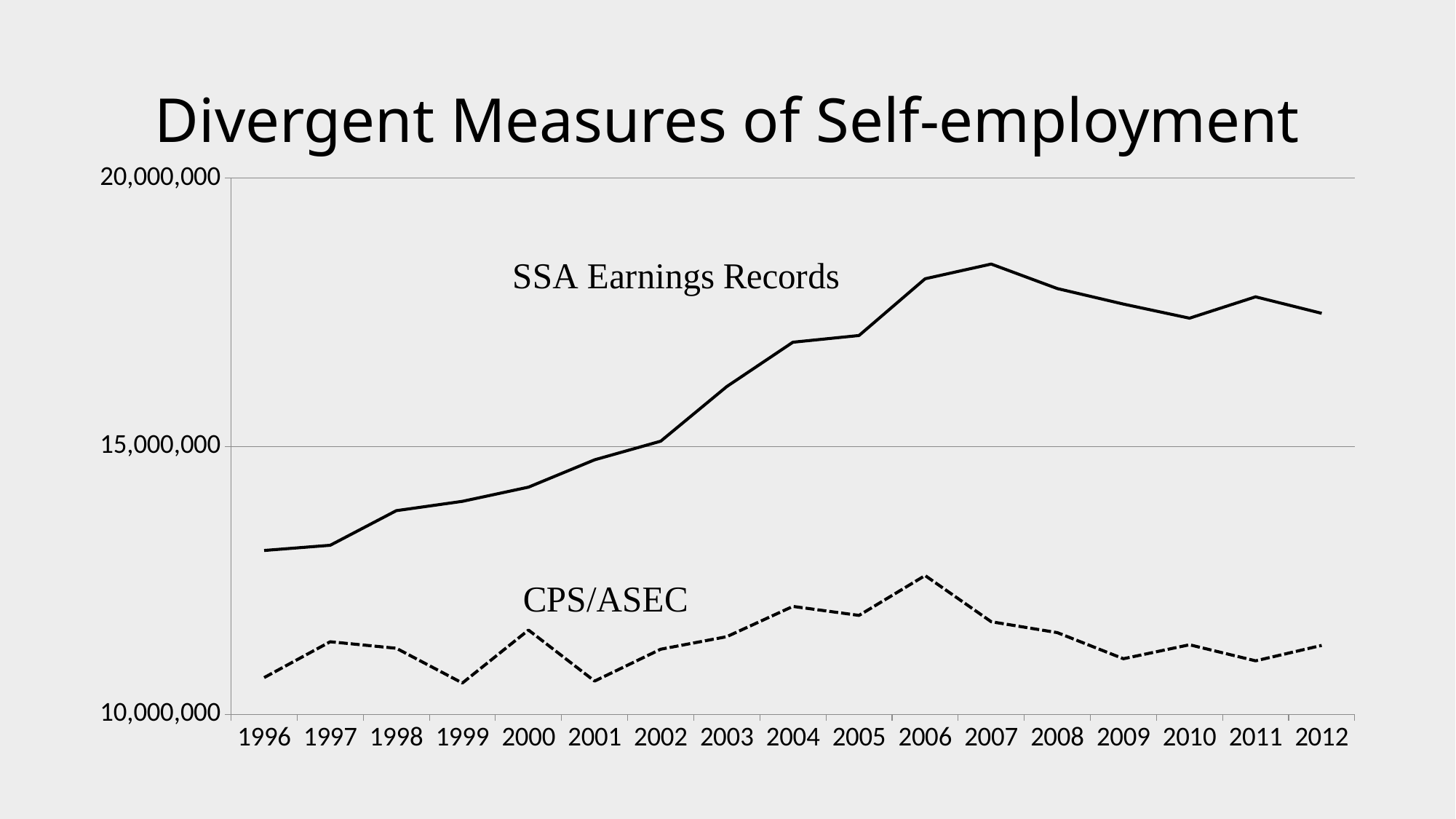
What is the title of the chart? Divergent Measures of Self-employment How many data series are plotted on the chart? 2 Is the value for SSA Earnings Records in 2003 greater or less than 15,000,000? greater In which year does the CPS/ASEC series reach its highest value? 2006 What kind of chart is shown on the slide? Line chart How many years are shown along the x axis? 17 Does the SSA Earnings Records series rise or fall between 1996 and 2007? Rise In 2012, which series has the larger value, SSA Earnings Records or CPS/ASEC? SSA Earnings Records Is the value for SSA Earnings Records in 1996 greater or less than 15,000,000? less Which series is drawn with a dashed line? CPS/ASEC In which year does the SSA Earnings Records series reach its highest value? 2007 Is the value for CPS/ASEC in 2006 greater or less than 15,000,000? less